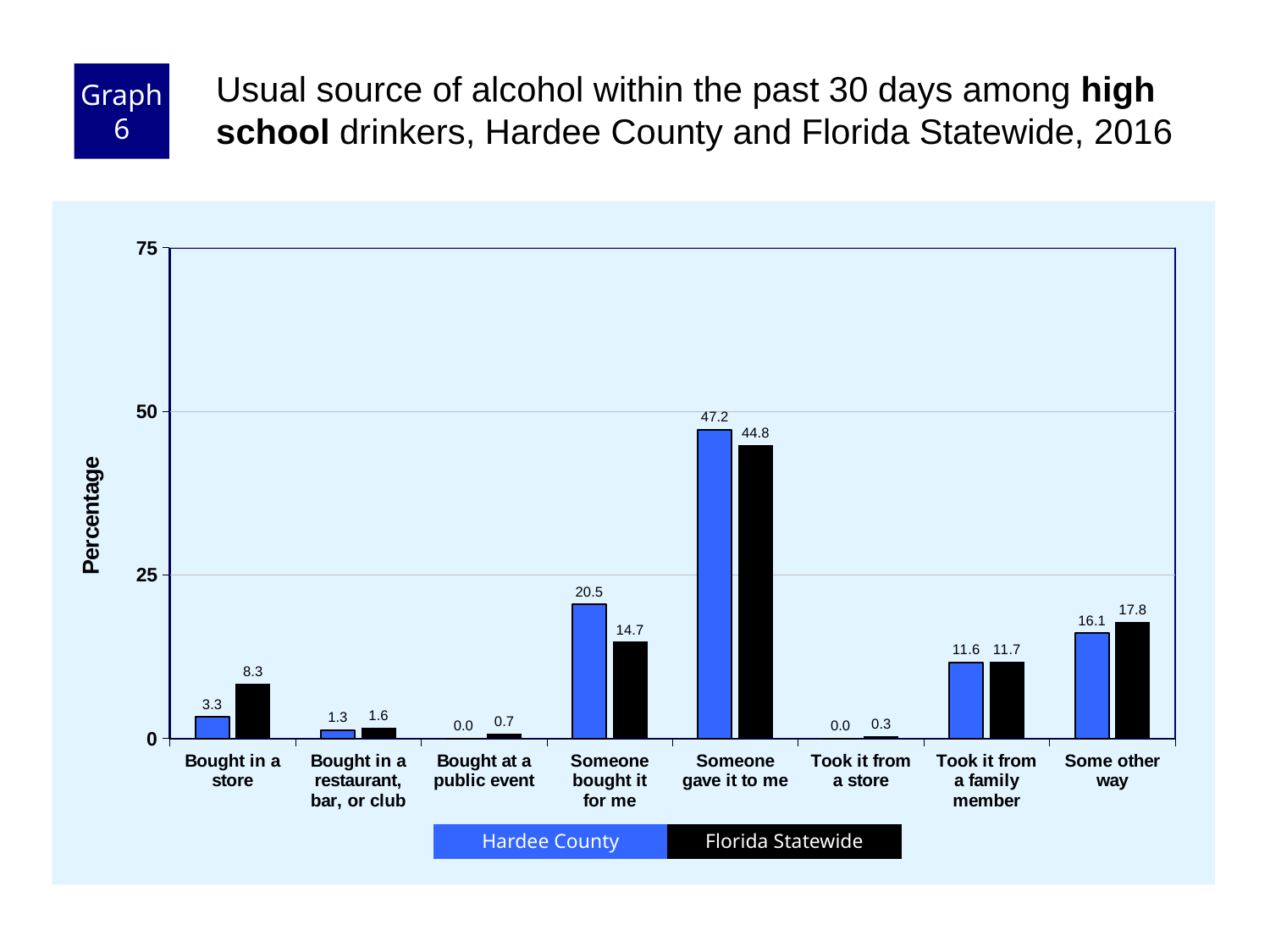
What is the difference between the Hardee County and Florida Statewide values for "Someone bought it for me"? 5.8 What is the Florida Statewide value for "Bought in a store"? 8.3 Is the Hardee County value for "Someone gave it to me" greater or less than 50? less What is the Hardee County value for "Someone gave it to me"? 47.2 How many series does the legend list? 2 Which is larger for "Some other way": Hardee County or Florida Statewide? Florida Statewide Which category has the highest Florida Statewide value? Someone gave it to me What kind of chart is shown on the slide? Bar chart Which category has the lowest Florida Statewide value? Took it from a store How many categories are shown on the x axis? 8 What is the label of the y axis? Percentage What is the Hardee County value for "Someone bought it for me"? 20.5